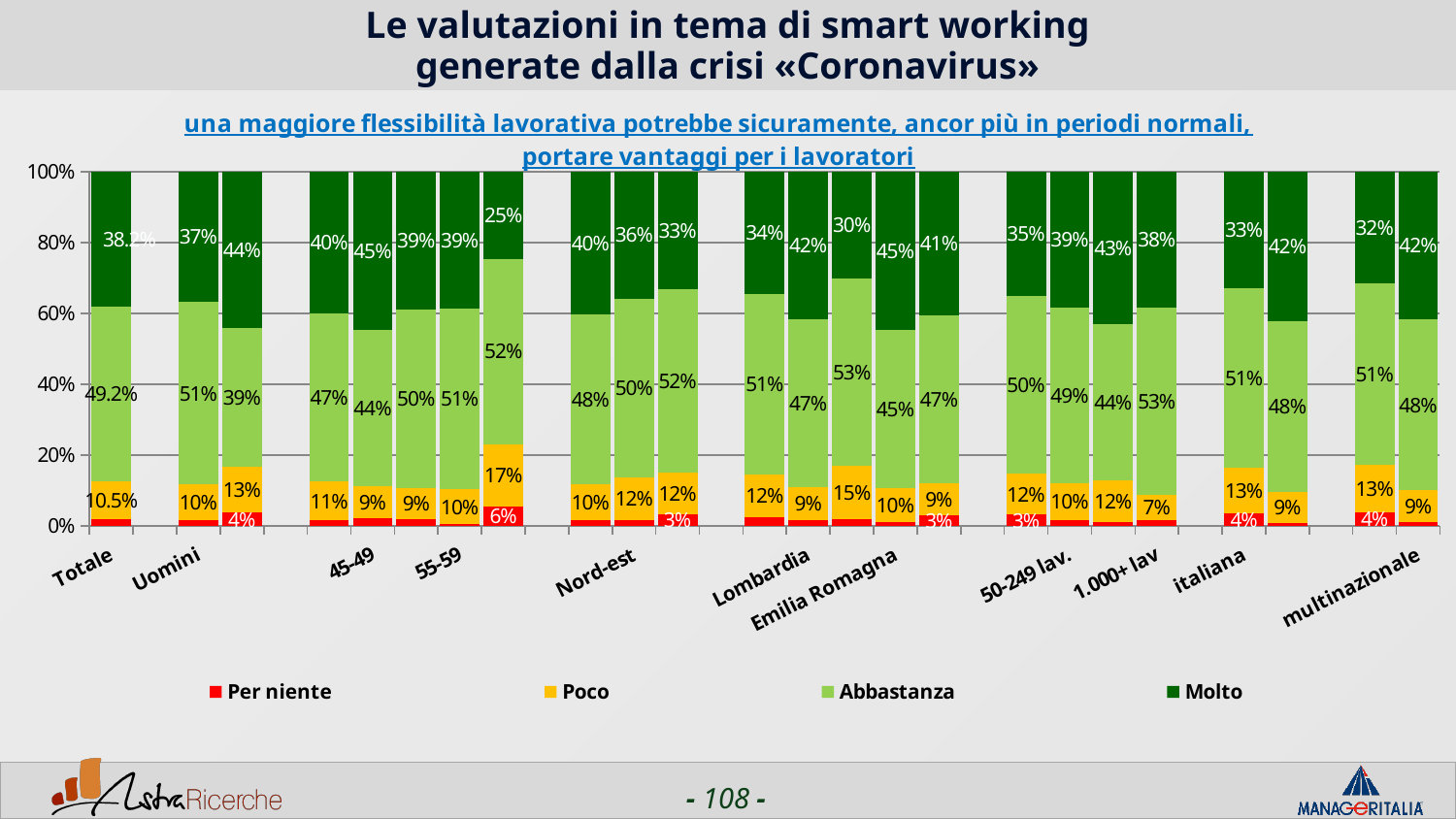
For Uomini, what is the difference between the Abbastanza value and the Molto value? 14 percentage points What is the Poco value for Uomini? 10% What kind of chart is shown on the slide? Stacked bar chart What is the Poco value for Totale? 10.5% What is the Molto value for Uomini? 37% What is the Abbastanza value for Uomini? 51% For Uomini, which is larger: the Abbastanza value or the Molto value? Abbastanza Which colour represents the Molto series in the chart? Dark green What is the Abbastanza value for Totale? 49.2% What are the four legend entries of the chart? Per niente, Poco, Abbastanza, Molto Is the Abbastanza value for Totale greater or less than 40%? greater How many series does the legend list? 4